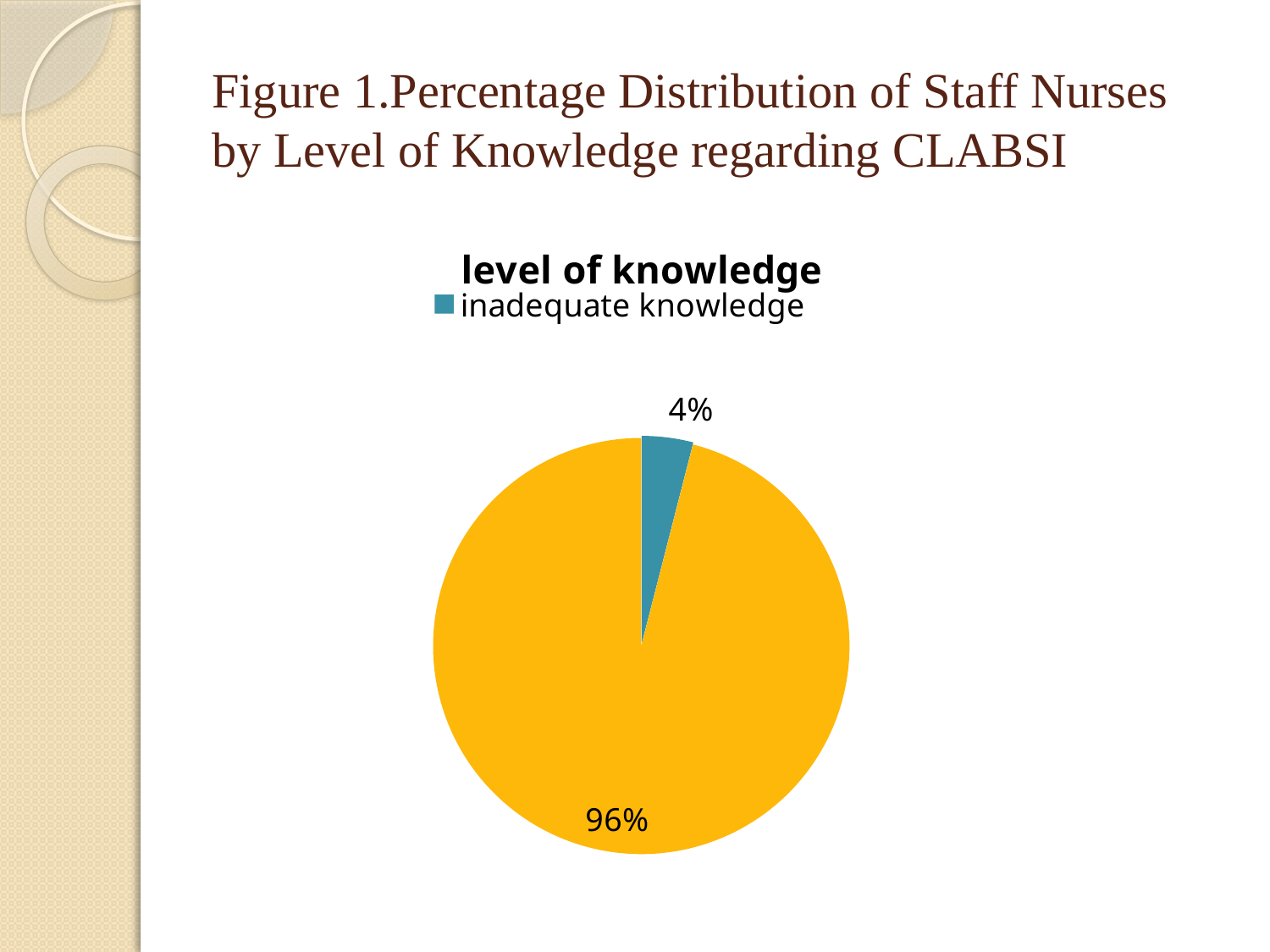
What is the difference in percentage points between the yellow slice and the inadequate knowledge slice? 92% What is the legend entry shown for the blue slice of the pie chart? inadequate knowledge Which slice of the pie chart is larger, the blue one or the yellow one? yellow What is the title of the pie chart? level of knowledge How many entries does the legend of the pie chart list? 1 What percentage is shown on the yellow slice of the pie chart? 96% What share of the pie does the inadequate knowledge slice represent? 4% How many slices does the pie chart have? 2 What percentage of staff nurses had inadequate knowledge according to the pie chart? 4% What kind of chart is shown on the slide? pie chart Which slice of the pie chart is the smallest? inadequate knowledge (4%) Is the inadequate knowledge slice greater or less than 50% of the pie? less